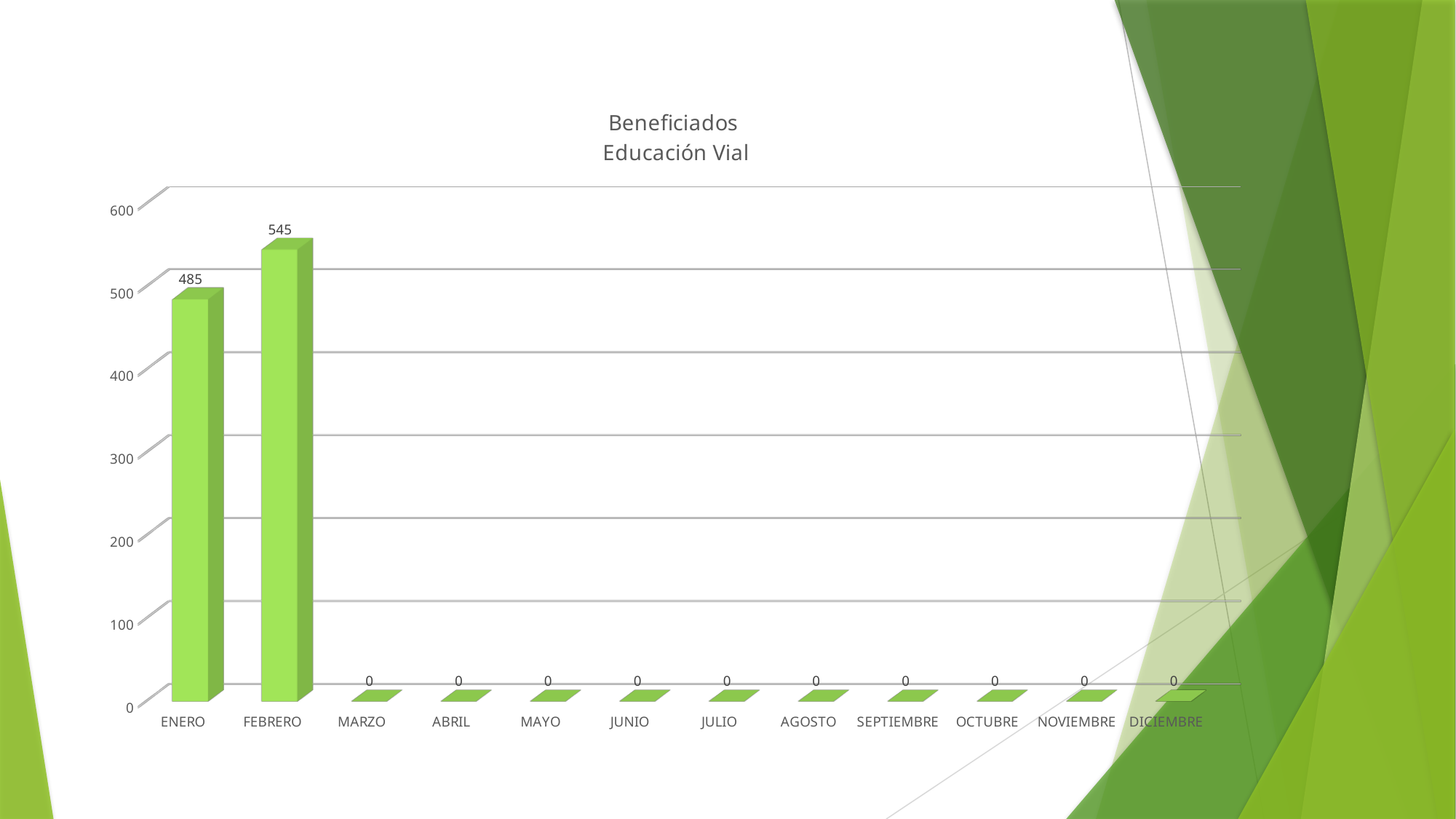
What is the value for FEBRERO? 545 Which month has the highest value? FEBRERO Is the value for ENERO greater or less than 400? greater What is the value for MARZO? 0 Which is larger, the value for ENERO or the value for FEBRERO? FEBRERO What is the title of the chart? Beneficiados Educación Vial What is the difference between the values for FEBRERO and ENERO? 60 How many months have a value of 0? 10 What kind of chart is shown on the slide? bar chart How many months are shown on the x axis? 12 What is the highest value shown on the vertical axis? 600 What is the value for ENERO? 485